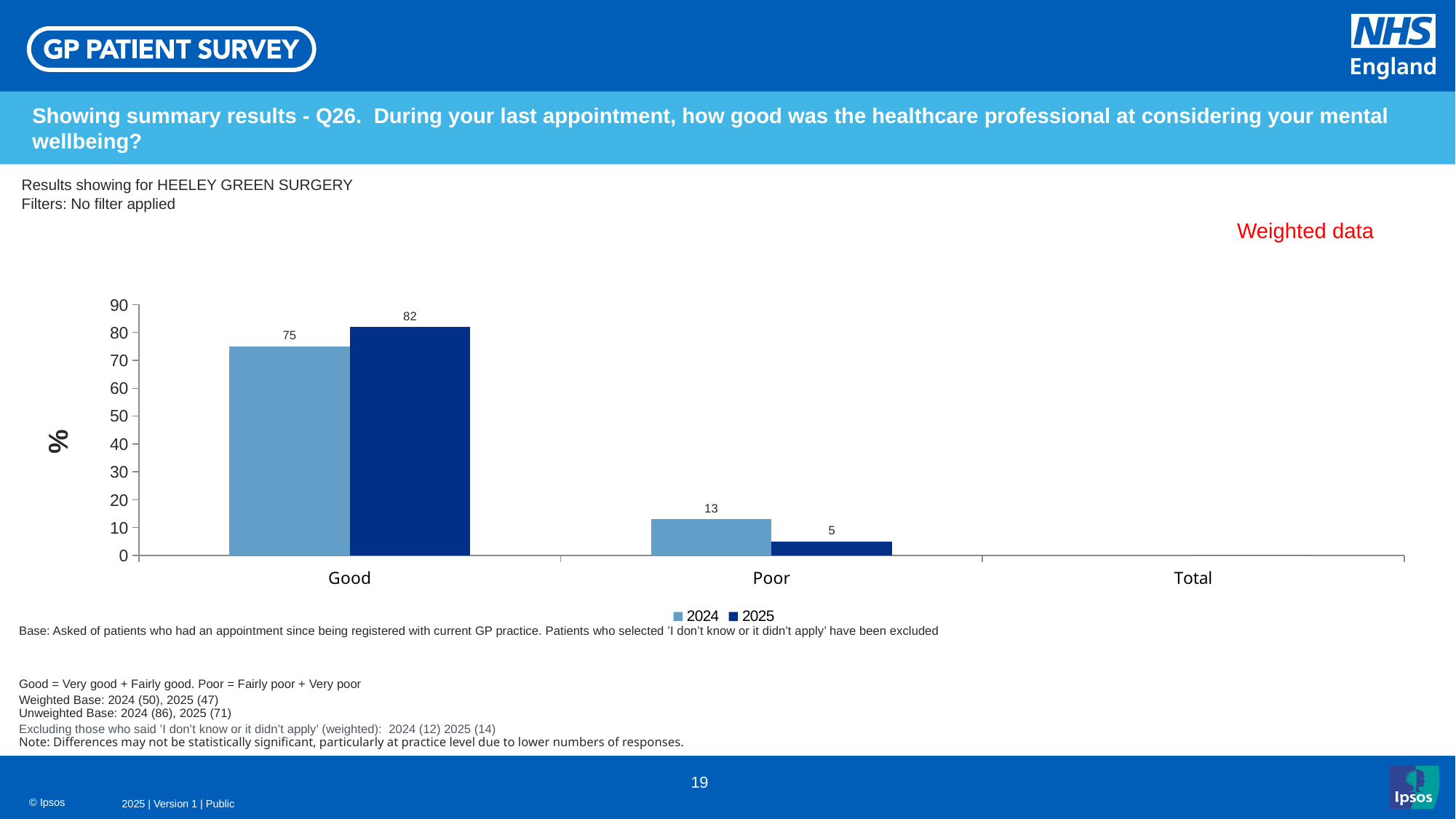
What label is shown on the vertical axis? % Is the value for Good in 2024 greater or less than 70? greater What kind of chart is shown on the slide? Bar chart What is the value for Poor in 2024? 13 Which category has the lowest value in 2025? Poor What is the value for Poor in 2025? 5 Which is larger, the 2024 value for Good or the 2025 value for Good? 2025 How many series does the legend list? 2 What is the value for Good in 2024? 75 What is the difference between the 2025 and 2024 values for Good? 7 What is the difference between the 2024 and 2025 values for Poor? 8 What is the value for Good in 2025? 82